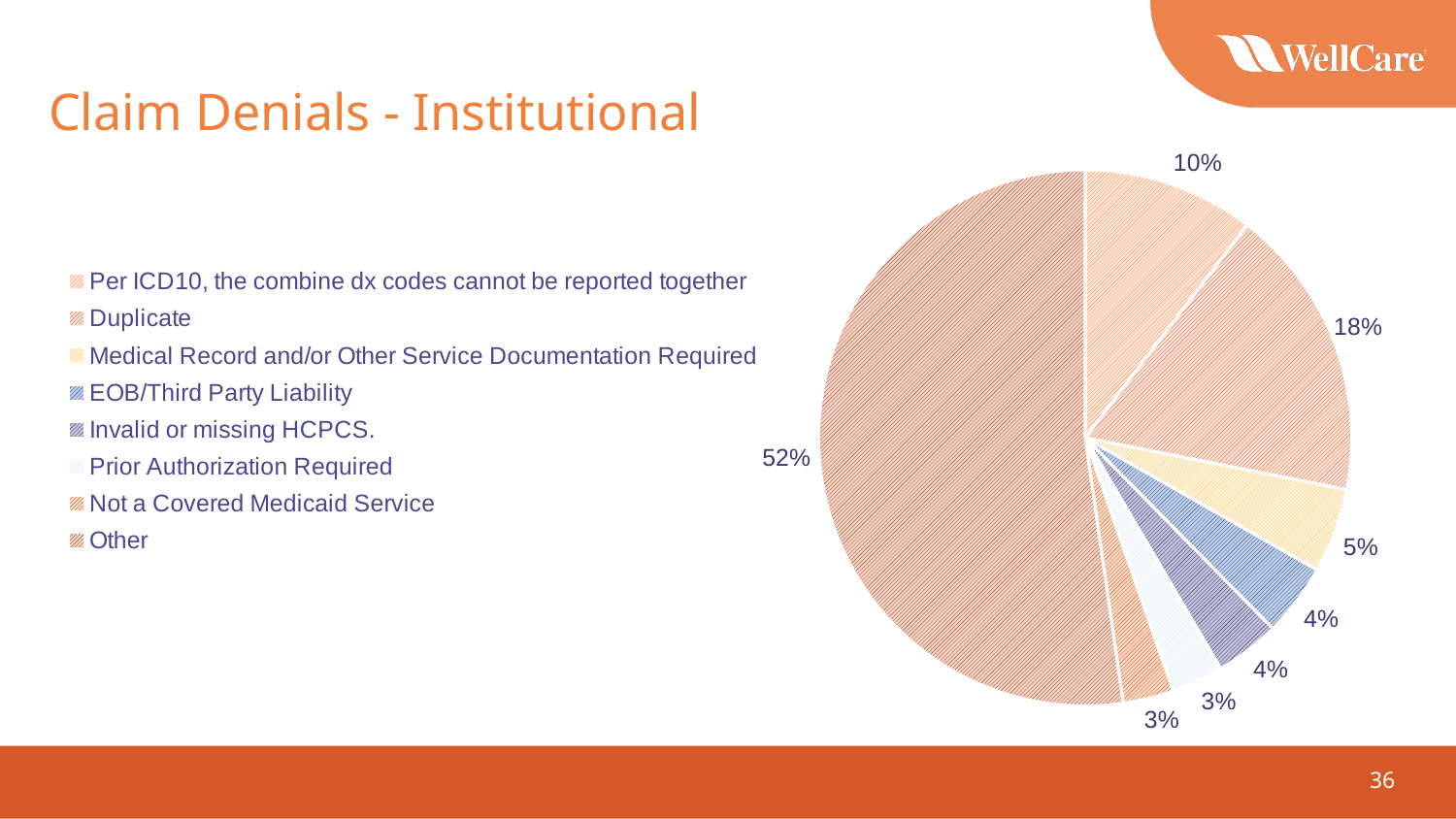
How many entries does the legend list? 8 What share of the pie is labelled "Other"? 52% What is the title of the chart on the slide? Claim Denials - Institutional What is the value for "Duplicate"? 18% Which is larger, the share for "Duplicate" or the share for "Per ICD10, the combine dx codes cannot be reported together"? Duplicate What is the difference between the share for "Duplicate" and the share for "Per ICD10, the combine dx codes cannot be reported together"? 8% What is the value for "Medical Record and/or Other Service Documentation Required"? 5% What is the value for "Per ICD10, the combine dx codes cannot be reported together"? 10% What is the smallest percentage shown on the pie chart? 3% Which category has the largest share of the pie? Other How many slices does the pie chart have? 8 What kind of chart is shown on the slide? pie chart